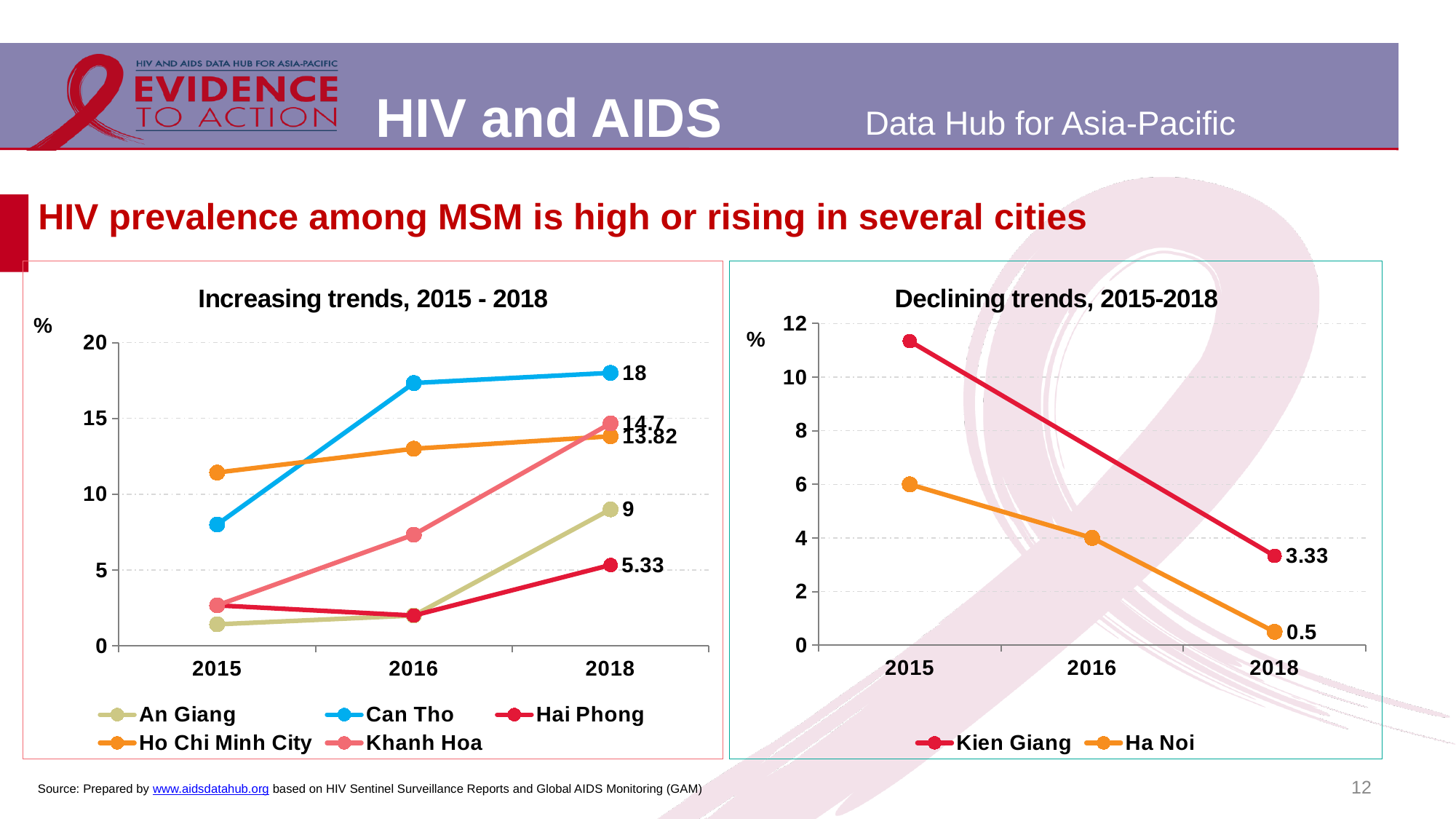
In the 'Increasing trends, 2015 - 2018' chart, which city has the lowest value in 2018? Hai Phong In the 'Declining trends, 2015-2018' chart, is the value for Kien Giang in 2015 greater or less than 10? greater In the 'Increasing trends, 2015 - 2018' chart, is the value for Can Tho in 2015 greater or less than 10? less How many series does the legend of the 'Increasing trends, 2015 - 2018' chart list? 5 How many years are shown on the x axis of the 'Declining trends, 2015-2018' chart? 3 In the 'Declining trends, 2015-2018' chart, what is the value for Ha Noi in 2018? 0.5 In the 'Increasing trends, 2015 - 2018' chart, which city has the highest value in 2018? Can Tho In the 'Declining trends, 2015-2018' chart, which city has the larger value in 2018, Kien Giang or Ha Noi? Kien Giang What kind of chart is the 'Declining trends, 2015-2018' chart? Line chart In the 'Increasing trends, 2015 - 2018' chart, what is the difference between the 2018 values for Can Tho and Hai Phong? 12.67 In the 'Increasing trends, 2015 - 2018' chart, what is the value for Can Tho in 2018? 18 In the 'Increasing trends, 2015 - 2018' chart, what is the value for Ho Chi Minh City in 2018? 13.82